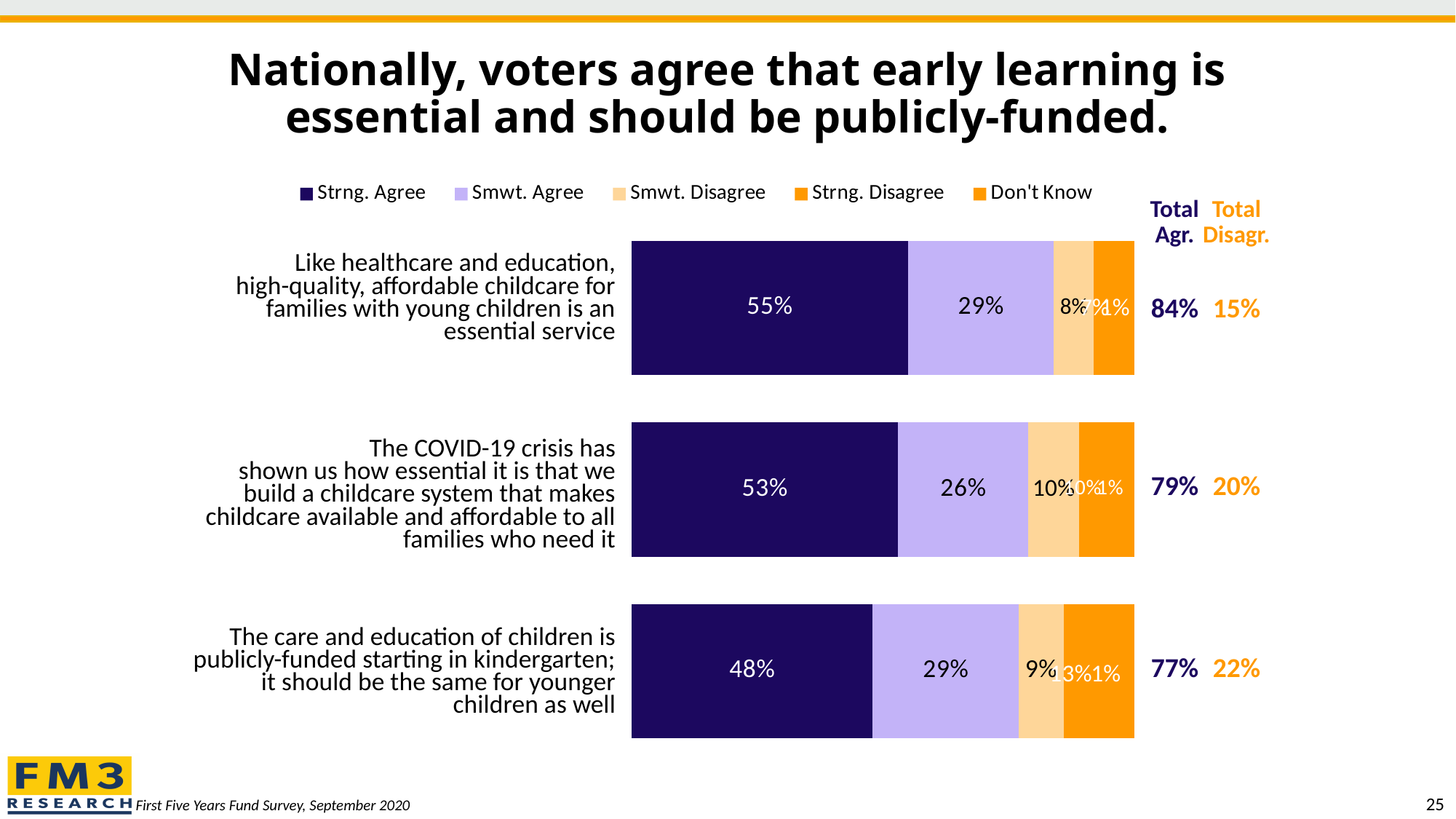
What is the difference between the Strng. Agree values for the essential service statement and the COVID-19 crisis statement? 2% Which statement has the highest Total Agr. figure? Like healthcare and education, high-quality, affordable childcare for families with young children is an essential service How many series does the legend list? 5 What percentage strongly agree that childcare is an essential service like healthcare and education? 55% How many statements are plotted in the chart? 3 What is the Strng. Agree value for the statement that care and education of younger children should be publicly funded like kindergarten? 48% What is the Total Agr. figure for the COVID-19 crisis statement? 79% What percentage somewhat agree with the statement about the COVID-19 crisis showing how essential a childcare system is? 26% Which statement has the lowest Strng. Agree value? The care and education of children is publicly-funded starting in kindergarten; it should be the same for younger children as well What kind of chart is shown on the slide? Stacked bar chart What is the Total Disagr. figure for the statement about publicly funding care and education of younger children? 22% Is the Smwt. Disagree value larger for the COVID-19 crisis statement or for the essential service statement? The COVID-19 crisis statement